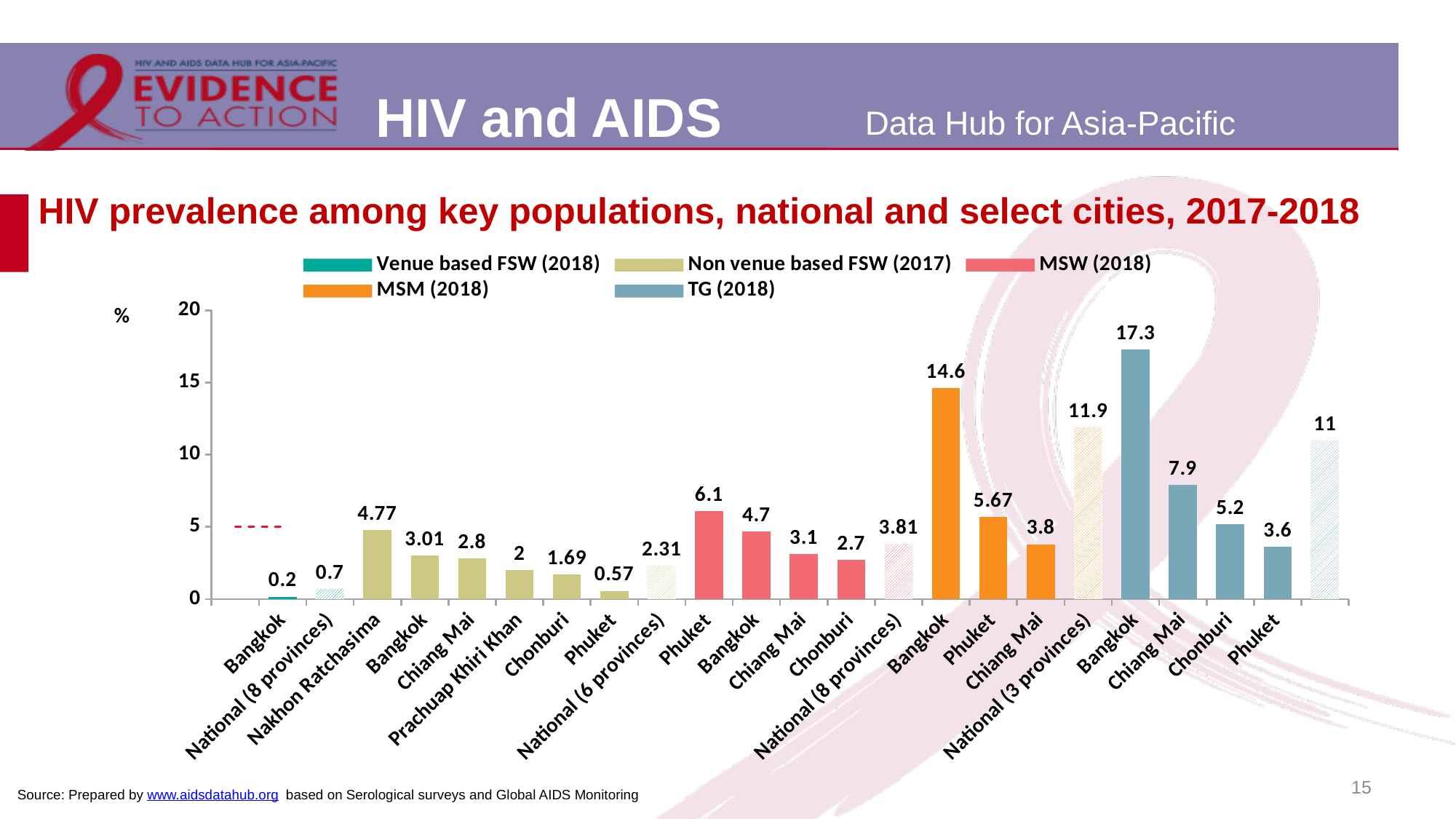
For MSW (2018), which is larger: Phuket or Bangkok? Phuket How many series does the legend list? 5 What is the value for Venue based FSW (2018) National (8 provinces)? 0.7 What is the difference between the MSM (2018) values for Bangkok and Phuket? 8.93 Among the Non venue based FSW (2017) bars, which location has the lowest value? Phuket Which bar has the highest value on the chart? TG (2018) Bangkok, 17.3 What kind of chart is shown on the slide? Bar chart What is the HIV prevalence for TG (2018) in Bangkok? 17.3 What is the value for MSM (2018) National (3 provinces)? 11.9 What is the HIV prevalence for MSM (2018) in Bangkok? 14.6 What is the difference between the TG (2018) values for Bangkok and Chiang Mai? 9.4 What is the value for Non venue based FSW (2017) in Nakhon Ratchasima? 4.77